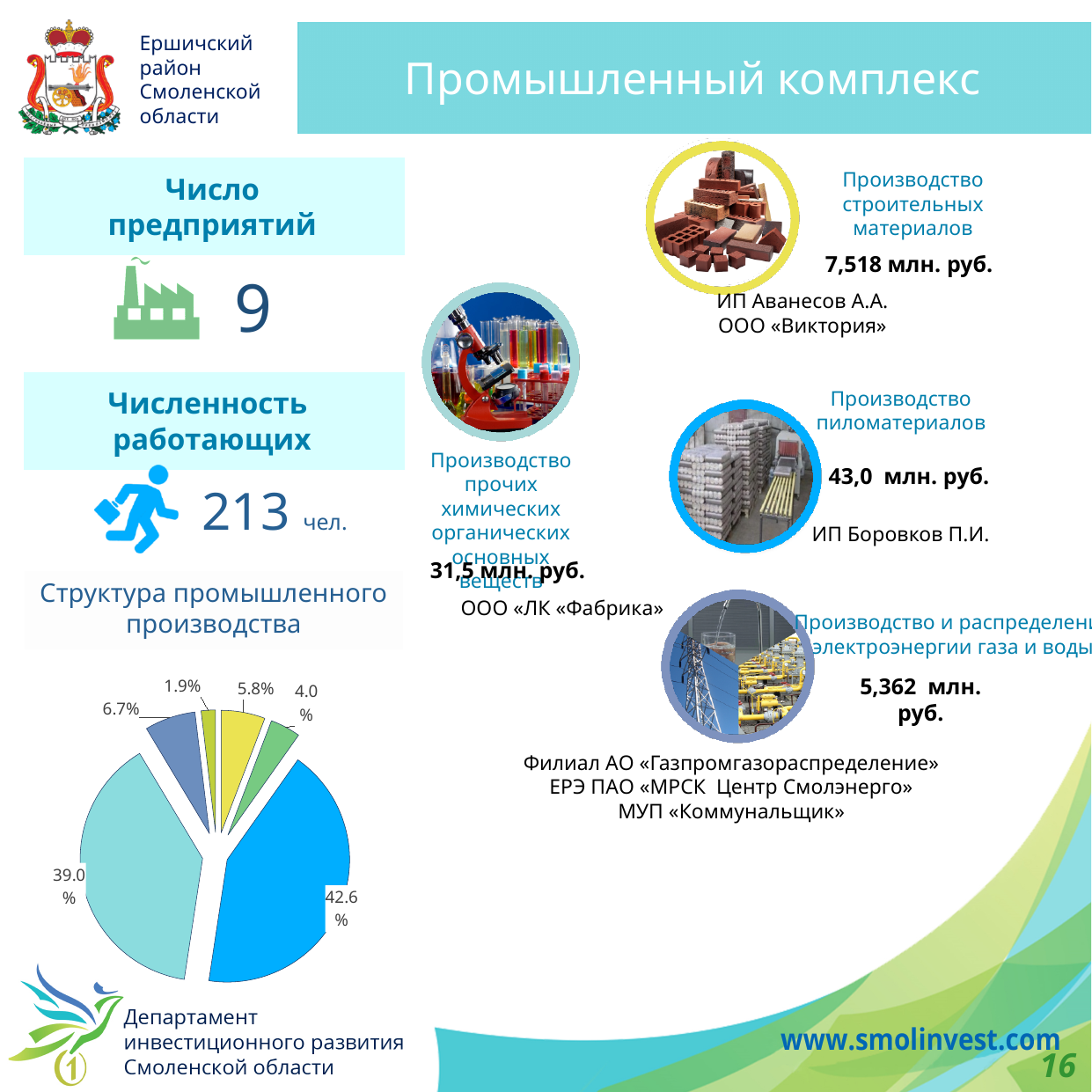
In the pie chart "Структура промышленного производства", what value is labelled on the yellow slice? 5.8% Does the pie chart "Структура промышленного производства" have a legend? No What is the largest value shown on the pie chart "Структура промышленного производства"? 42.6% In the pie chart "Структура промышленного производства", what value is labelled on the green slice? 4.0% In the pie chart "Структура промышленного производства", what value is labelled on the light cyan slice on the left? 39.0% What kind of chart is shown under the heading "Структура промышленного производства"? pie chart What is the title of the pie chart on the slide? Структура промышленного производства In the pie chart "Структура промышленного производства", what is the difference between the two largest slices, 42.6% and 39.0%? 3.6% In the pie chart "Структура промышленного производства", what is the combined share of the 6.7% and 1.9% slices? 8.6% How many slices does the pie chart "Структура промышленного производства" have? 6 In the pie chart "Структура промышленного производства", which is larger: the 5.8% slice or the 4.0% slice? 5.8% What is the smallest value shown on the pie chart "Структура промышленного производства"? 1.9%